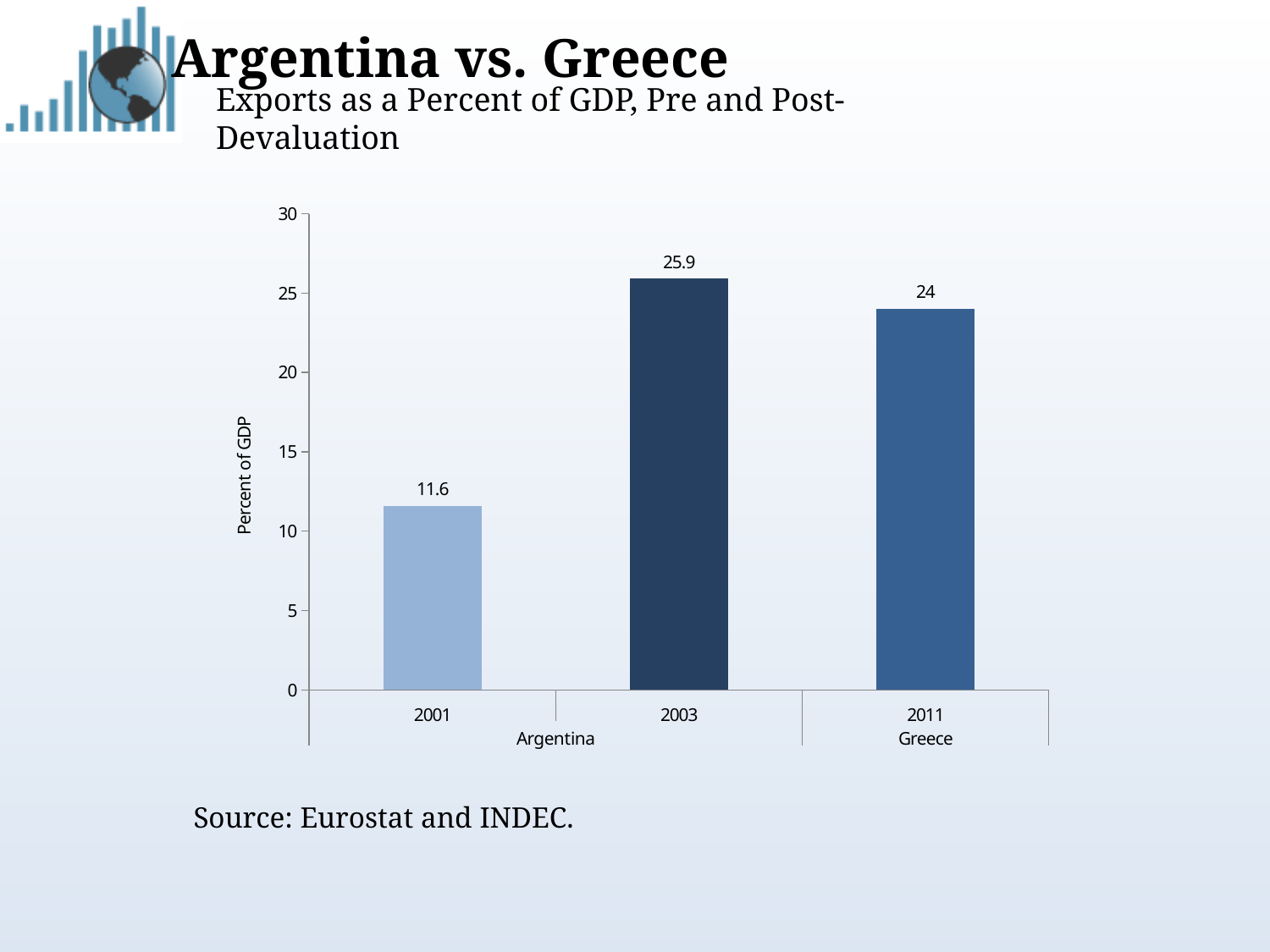
What is the difference between Argentina's 2003 value and Greece's 2011 value? 1.9 Which bar has the lowest value? Argentina 2001 What is the value for Argentina in 2003? 25.9 What is the value for Argentina in 2001? 11.6 What is the value for Greece in 2011? 24 Which bar has the highest value? Argentina 2003 What kind of chart is shown on the slide? bar chart Which is larger, Argentina's 2001 value or Greece's 2011 value? Greece 2011 What is the label on the vertical axis of the chart? Percent of GDP How many bars are plotted in the chart? 3 Is the value for Argentina in 2001 greater or less than 15? less What is the difference between Argentina's 2003 value and its 2001 value? 14.3